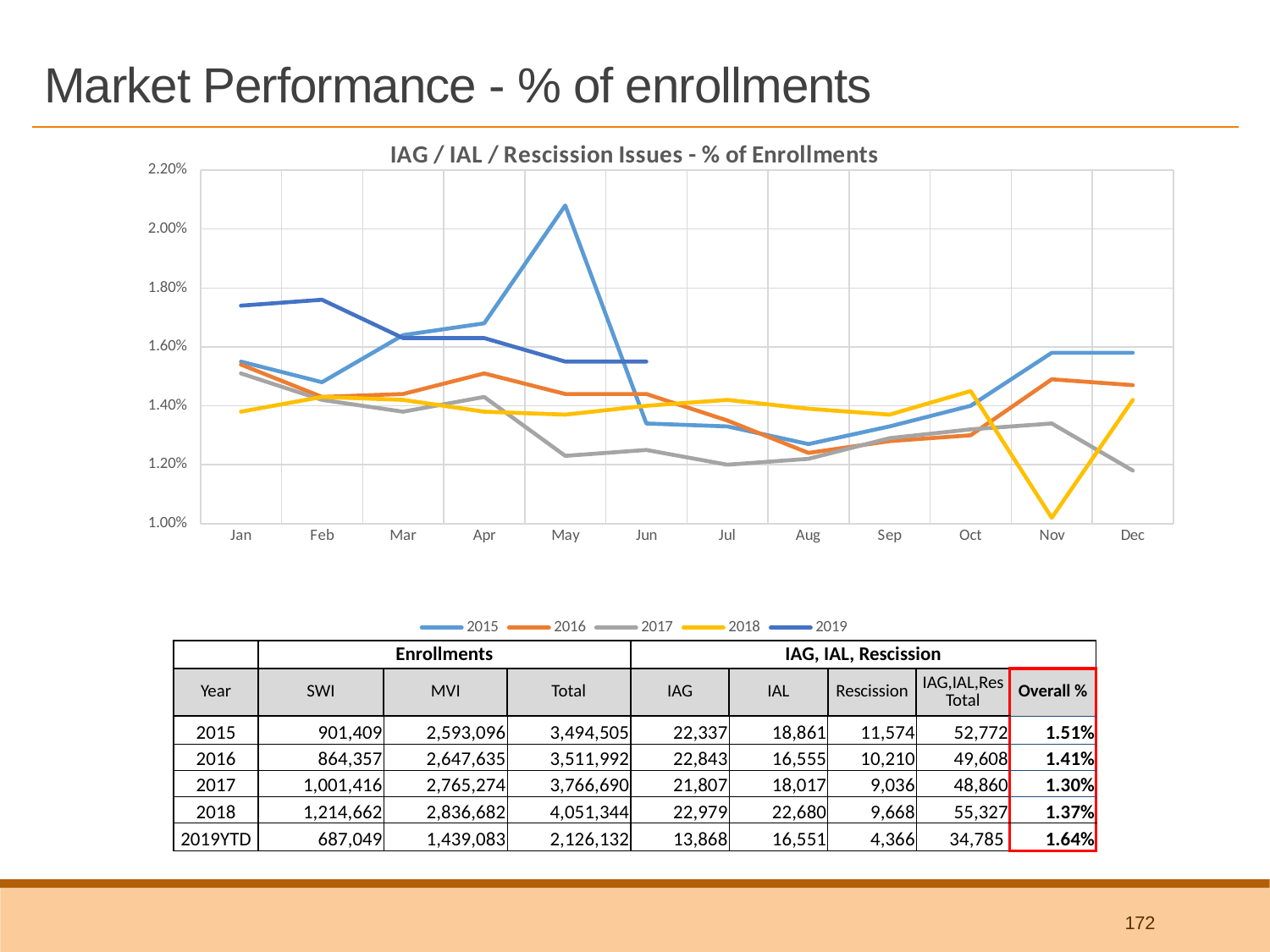
Which is larger in Jan, the value for 2019 or the value for 2015? 2019 Is the value for 2018 in Nov greater or less than 1.20%? less Which series has the highest value in Jan? 2019 How many series does the chart legend list? 5 In which month does the 2015 series reach its highest value? May What kind of chart is shown on the slide? line chart What is the title of the chart? IAG / IAL / Rescission Issues - % of Enrollments How many months are shown along the x axis of the chart? 12 Is the value for 2015 in May greater or less than 2.00%? greater Does the 2019 series rise or fall overall from Jan to Jun? fall Is the value for 2019 in Jan greater or less than 1.60%? greater In which month does the 2018 series reach its lowest value? Nov